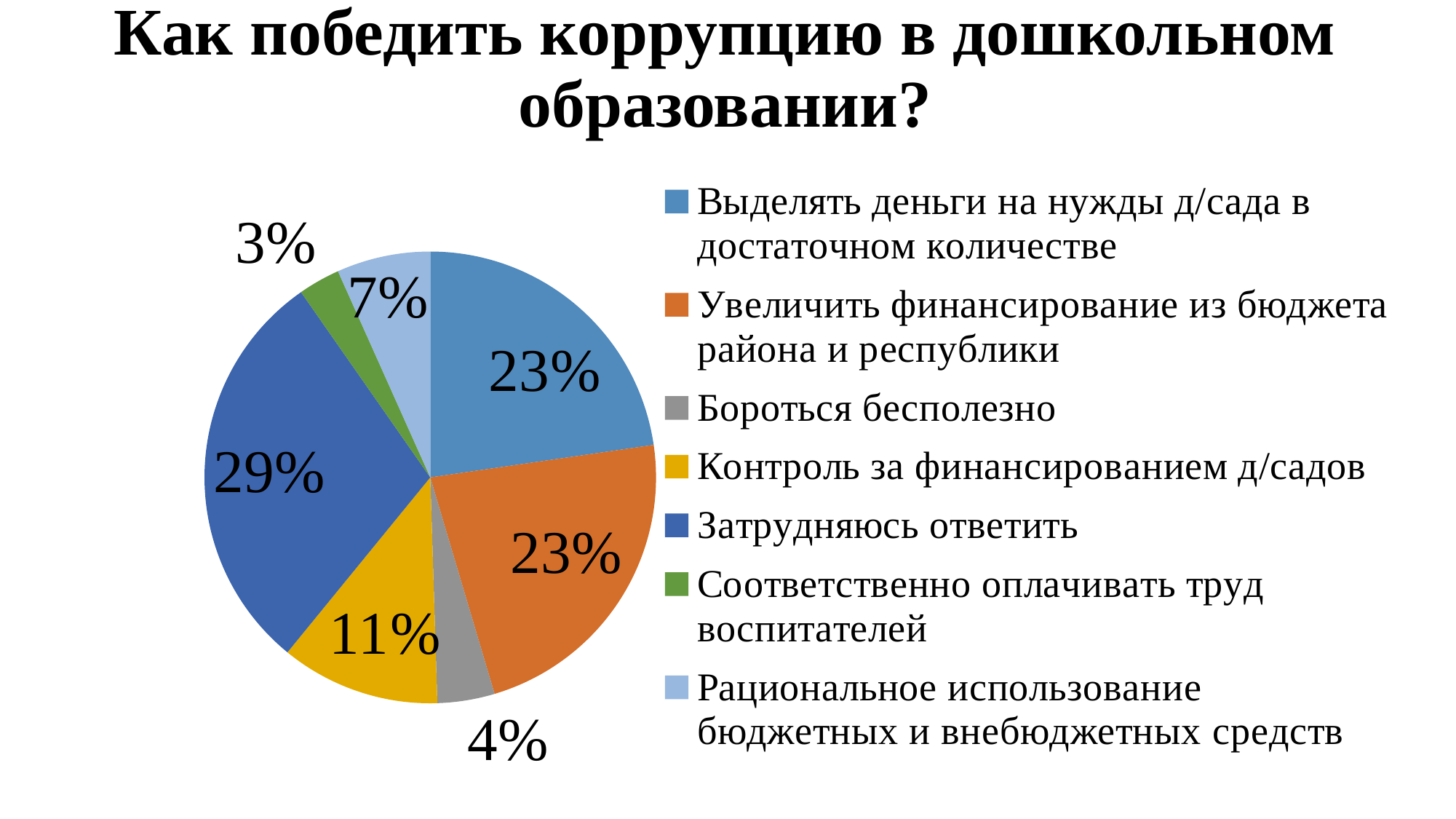
What is the value for "Контроль за финансированием д/садов"? 11% What is the title of the slide? Как победить коррупцию в дошкольном образовании? Which is larger: the share for "Рациональное использование бюджетных и внебюджетных средств" or the share for "Бороться бесполезно"? Рациональное использование бюджетных и внебюджетных средств What is the value for "Соответственно оплачивать труд воспитателей"? 3% What is the difference between the share for "Затрудняюсь ответить" and the share for "Контроль за финансированием д/садов"? 18% What is the value for "Бороться бесполезно"? 4% How many categories does the pie chart have? 7 Which category has the smallest share of the pie? Соответственно оплачивать труд воспитателей What share of the pie does "Затрудняюсь ответить" take? 29% What is the value for "Рациональное использование бюджетных и внебюджетных средств"? 7% Which category has the largest share of the pie? Затрудняюсь ответить What kind of chart is shown on the slide? pie chart